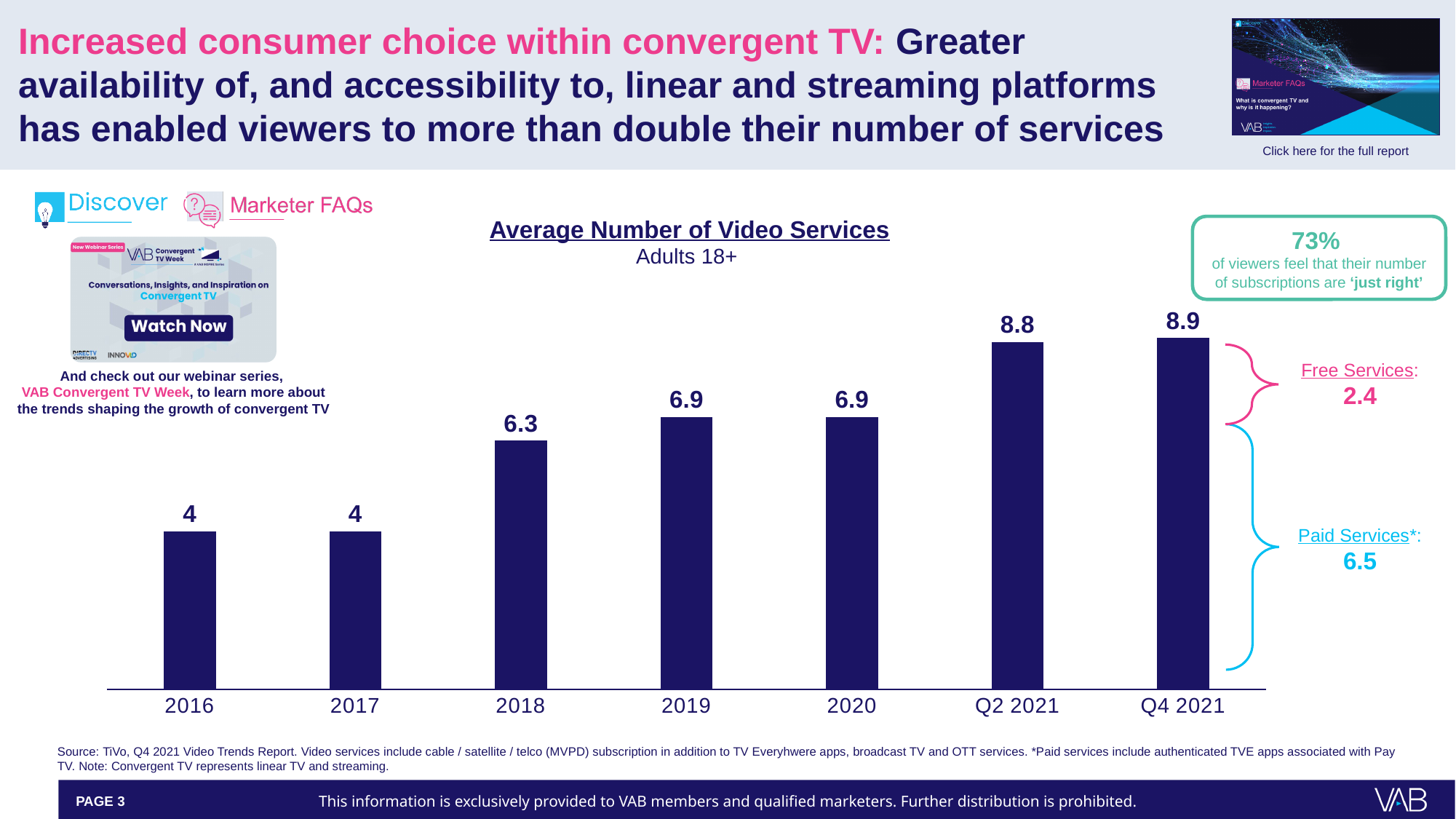
What kind of chart is used to show the average number of video services? Bar chart What is the difference in average number of video services between 2018 and 2017? 2.3 What is the average number of video services in 2016? 4 How many periods are shown on the x axis of the chart? 7 According to the annotation, how many of the Q4 2021 services are paid services? 6.5 What is the average number of video services in 2018? 6.3 What is the title of the chart? Average Number of Video Services What is the average number of video services in Q4 2021? 8.9 Which is larger, the average number of video services in 2019 or in 2017? 2019 What is the difference in average number of video services between Q4 2021 and 2016? 4.9 Do the values generally rise or fall from 2016 to Q4 2021? Rise Which period has the highest average number of video services? Q4 2021